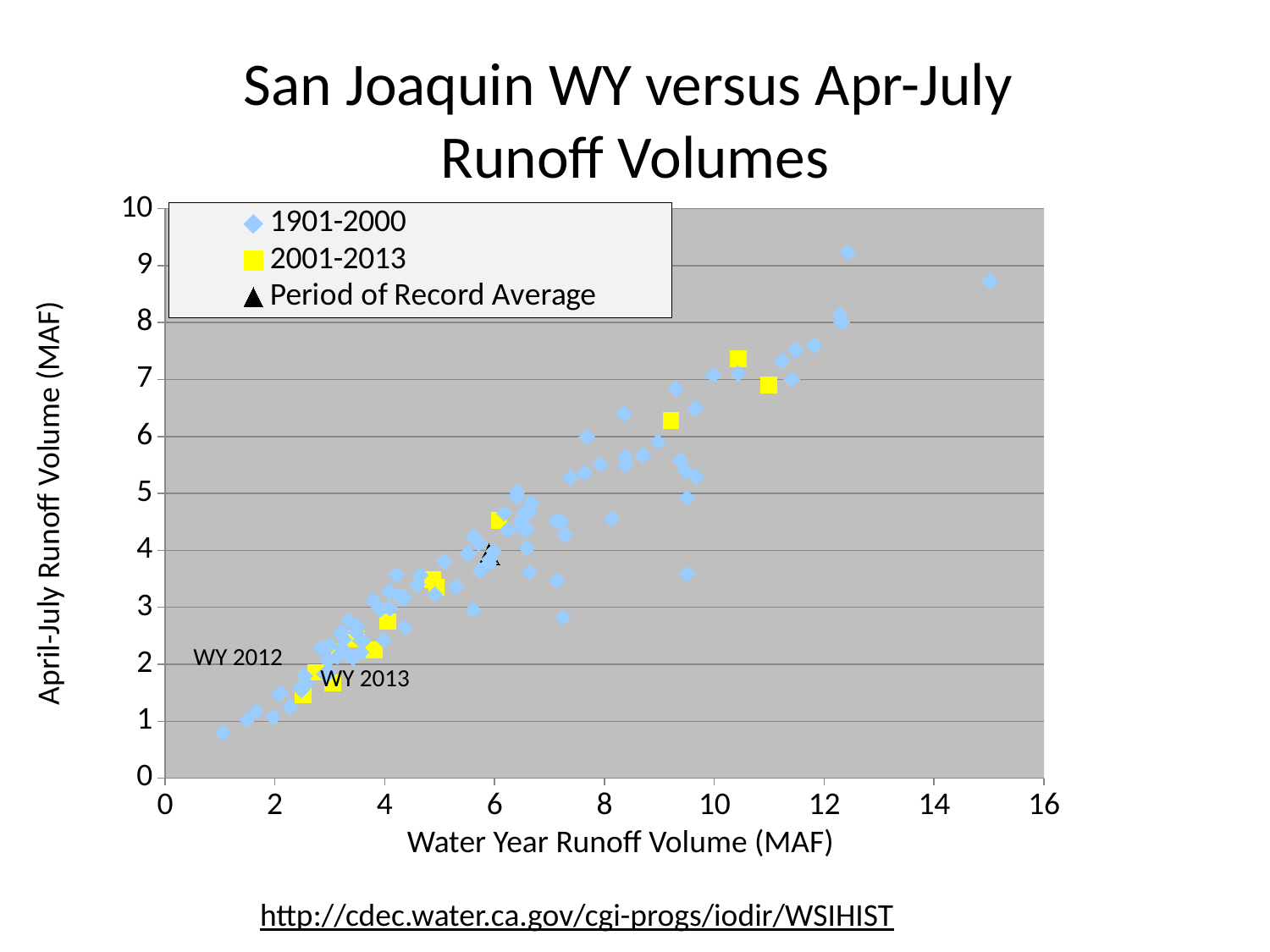
As Water Year Runoff Volume increases along the x axis, does April-July Runoff Volume generally rise or fall? rise Which series contains the point with the highest April-July Runoff Volume? 1901-2000 Is the April-July Runoff Volume for the point labelled WY 2012 greater or less than 2? less What kind of chart is shown on the slide? scatter chart How many series does the legend list? 3 Is the April-July Runoff Volume of the highest 1901-2000 point greater or less than 8? greater What is the label of the x axis? Water Year Runoff Volume (MAF) Which series is shown with yellow square markers? 2001-2013 Is the Water Year Runoff Volume of the Period of Record Average point greater or less than 8? less What is the title of the chart? San Joaquin WY versus Apr-July Runoff Volumes Which point has the larger Water Year Runoff Volume, WY 2012 or WY 2013? WY 2013